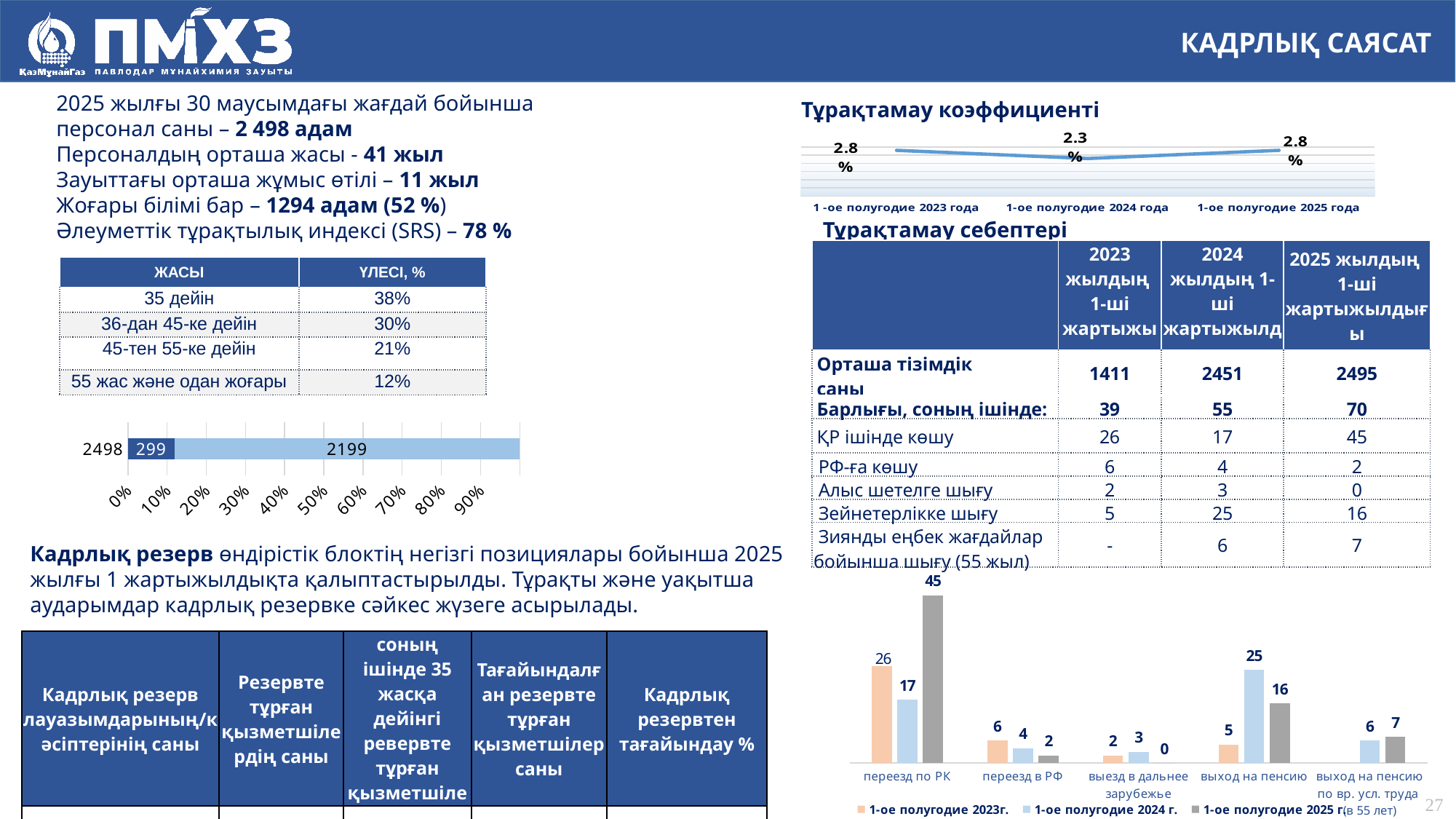
In the line chart titled "Тұрақтамау коэффициенті", how many data points are plotted? 3 In the grouped bar chart at the bottom right, how many series does the legend list? 3 In the line chart titled "Тұрақтамау коэффициенті", what is the value for 1-ое полугодие 2025 года? 2.8% In the grouped bar chart at the bottom right, what is the value for "выход на пенсию" in 1-ое полугодие 2024 г.? 25 In the grouped bar chart at the bottom right, what is the value for "переезд по РК" in 1-ое полугодие 2025 г.? 45 In the grouped bar chart at the bottom right, what is the difference between the 1-ое полугодие 2025 г. and 1-ое полугодие 2023 г. values for "переезд по РК"? 19 In the line chart titled "Тұрақтамау коэффициенті", does the value rise or fall from 1-ое полугодие 2024 года to 1-ое полугодие 2025 года? rise In the horizontal stacked bar chart on the left side of the slide, what is the total of the two segments? 2498 In the horizontal stacked bar chart on the left side of the slide, what is the value of the larger (light blue) segment? 2199 In the grouped bar chart at the bottom right, which is larger for "переезд в РФ": the 1-ое полугодие 2023г. value or the 1-ое полугодие 2025 г. value? 1-ое полугодие 2023г. In the line chart titled "Тұрақтамау коэффициенті", what is the value for 1-ое полугодие 2024 года? 2.3% In the line chart titled "Тұрақтамау коэффициенті", which period has the lowest value? 1-ое полугодие 2024 года